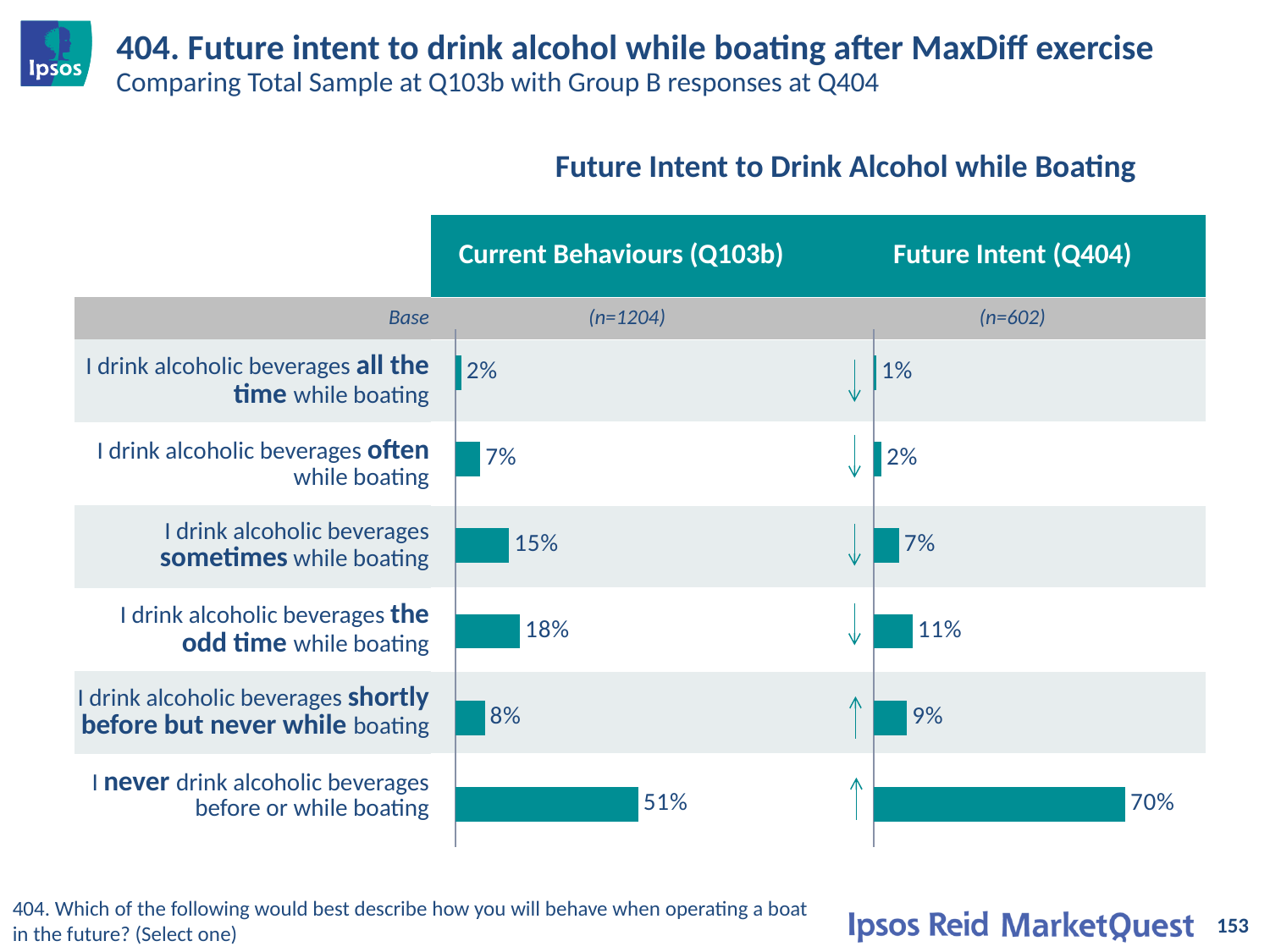
What is the difference between the Future Intent (Q404) value and the Current Behaviours (Q103b) value for "I never drink alcoholic beverages before or while boating"? 19% What kind of chart is used to show the Future Intent (Q404) data? Bar chart In the Current Behaviours (Q103b) chart, what is the value for "I never drink alcoholic beverages before or while boating"? 51% In the Future Intent (Q404) chart, what is the value for "I drink alcoholic beverages the odd time while boating"? 11% In the Future Intent (Q404) chart, which category has the lowest value? I drink alcoholic beverages all the time while boating What is the title shown above the two charts? Future Intent to Drink Alcohol while Boating In the Future Intent (Q404) chart, which category has the highest value? I never drink alcoholic beverages before or while boating In the Current Behaviours (Q103b) chart, what is the value for "I drink alcoholic beverages sometimes while boating"? 15% For "I drink alcoholic beverages shortly before but never while boating", which is larger: the Current Behaviours (Q103b) value or the Future Intent (Q404) value? Future Intent (Q404) How many categories are shown in the Current Behaviours (Q103b) chart? 6 In the Current Behaviours (Q103b) chart, what is the difference between "the odd time" and "sometimes"? 3% What is the base size (n) shown for the Future Intent (Q404) chart? n=602